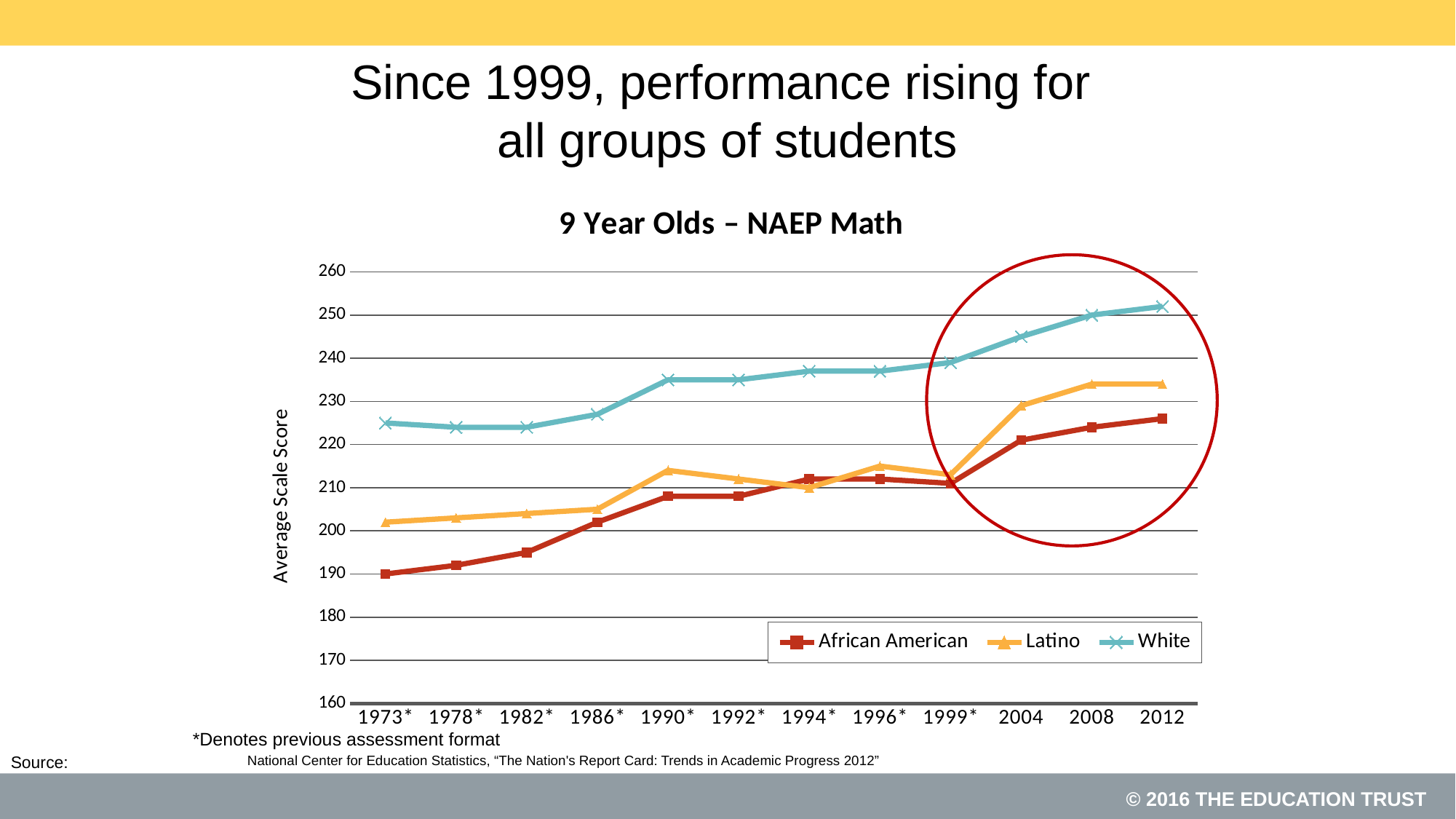
Which group has the lowest average scale score in 1973*? African American Which group has the highest average scale score in 2012? White What is the average scale score for African American students in 1973*? 190 Does the average scale score for White students rise or fall from 1999* to 2012? rise Is the value for African American students in 2012 greater or less than 230? less What type of chart is shown on the slide? line chart What is the average scale score for White students in 2008? 250 How many assessment years are shown on the x axis? 12 What is the title of the chart? 9 Year Olds – NAEP Math Is the value for White students in 2012 greater or less than 250? greater In 2012, which group has the larger average scale score, Latino or African American? Latino How many series does the legend list? 3